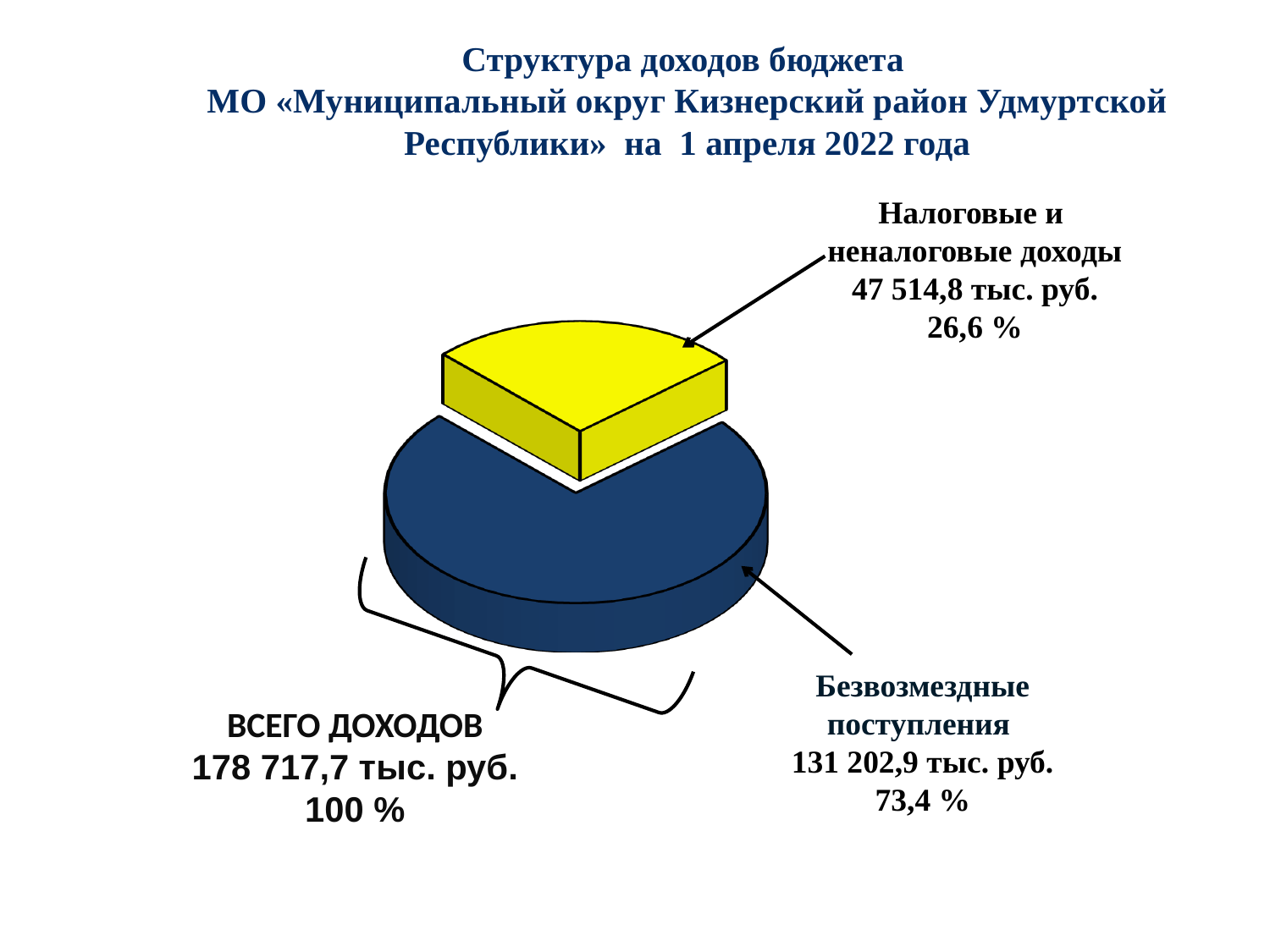
What is the value for «Налоговые и неналоговые доходы»? 47 514,8 тыс. руб. Which slice is the smallest? Налоговые и неналоговые доходы What kind of chart is shown on the slide? Pie chart What is the difference in value between «Безвозмездные поступления» and «Налоговые и неналоговые доходы»? 83 688,1 тыс. руб. What is the value for «Безвозмездные поступления»? 131 202,9 тыс. руб. What is the total of all income shown (ВСЕГО ДОХОДОВ)? 178 717,7 тыс. руб. How many slices does the pie chart have? 2 Which slice is the largest? Безвозмездные поступления What colour is the slice for «Налоговые и неналоговые доходы»? Yellow What share of the pie does «Налоговые и неналоговые доходы» represent? 26,6 % What share of the pie does «Безвозмездные поступления» represent? 73,4 % Which is larger: «Налоговые и неналоговые доходы» or «Безвозмездные поступления»? Безвозмездные поступления